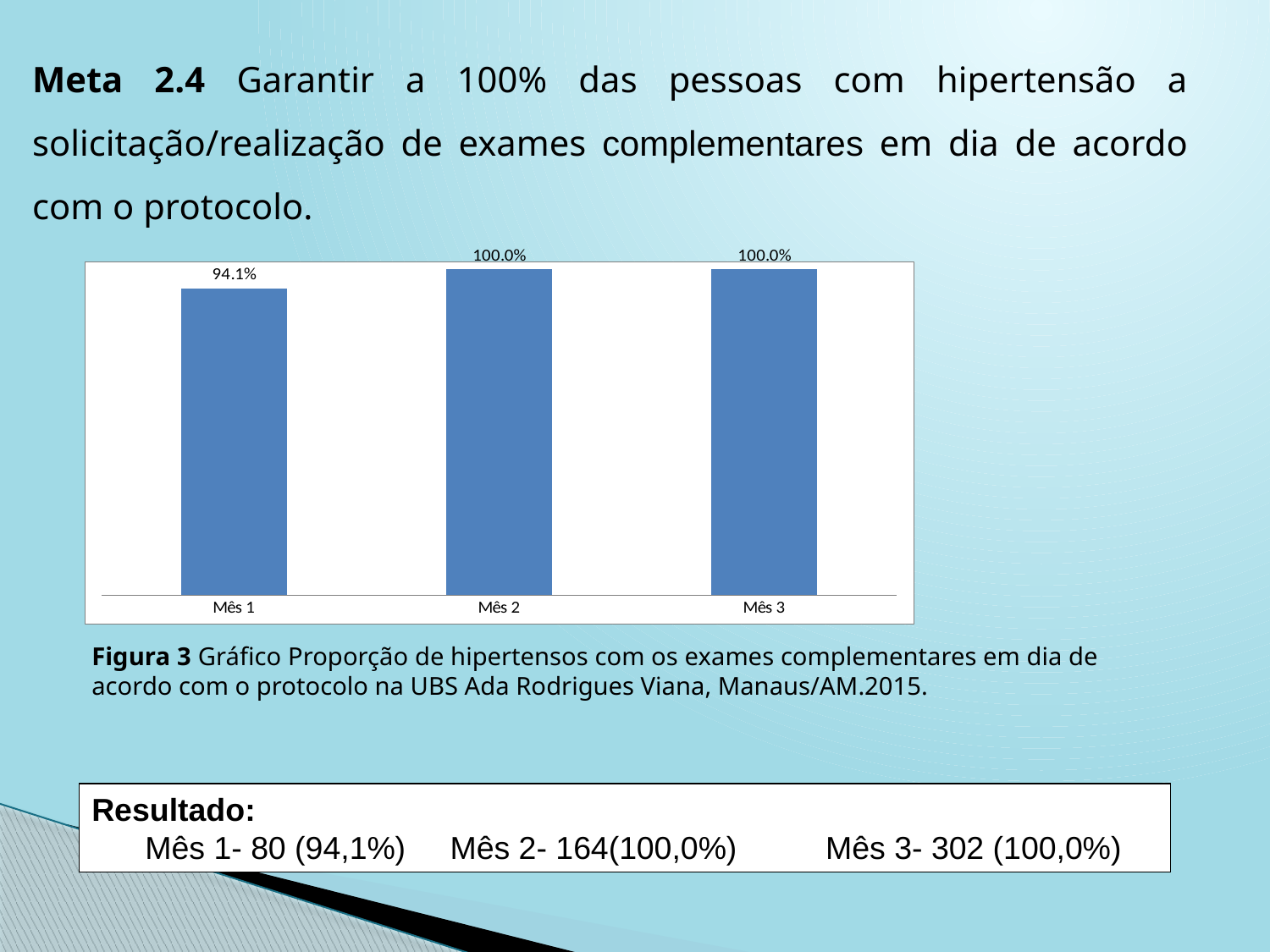
Does the value change between Mês 2 and Mês 3? No Which category has the lowest value? Mês 1 What is the difference between the values for Mês 2 and Mês 1? 5.9% Do the values rise or fall from Mês 1 to Mês 2? Rise According to the figure caption, which UBS does the chart refer to? UBS Ada Rodrigues Viana Which is larger, the value for Mês 1 or the value for Mês 3? Mês 3 What is the value for Mês 1? 94.1% What colour are the bars in the chart? Blue How many categories are shown on the x axis? 3 What kind of chart is shown on the slide? Bar chart What is the value for Mês 3? 100.0% What is the value for Mês 2? 100.0%